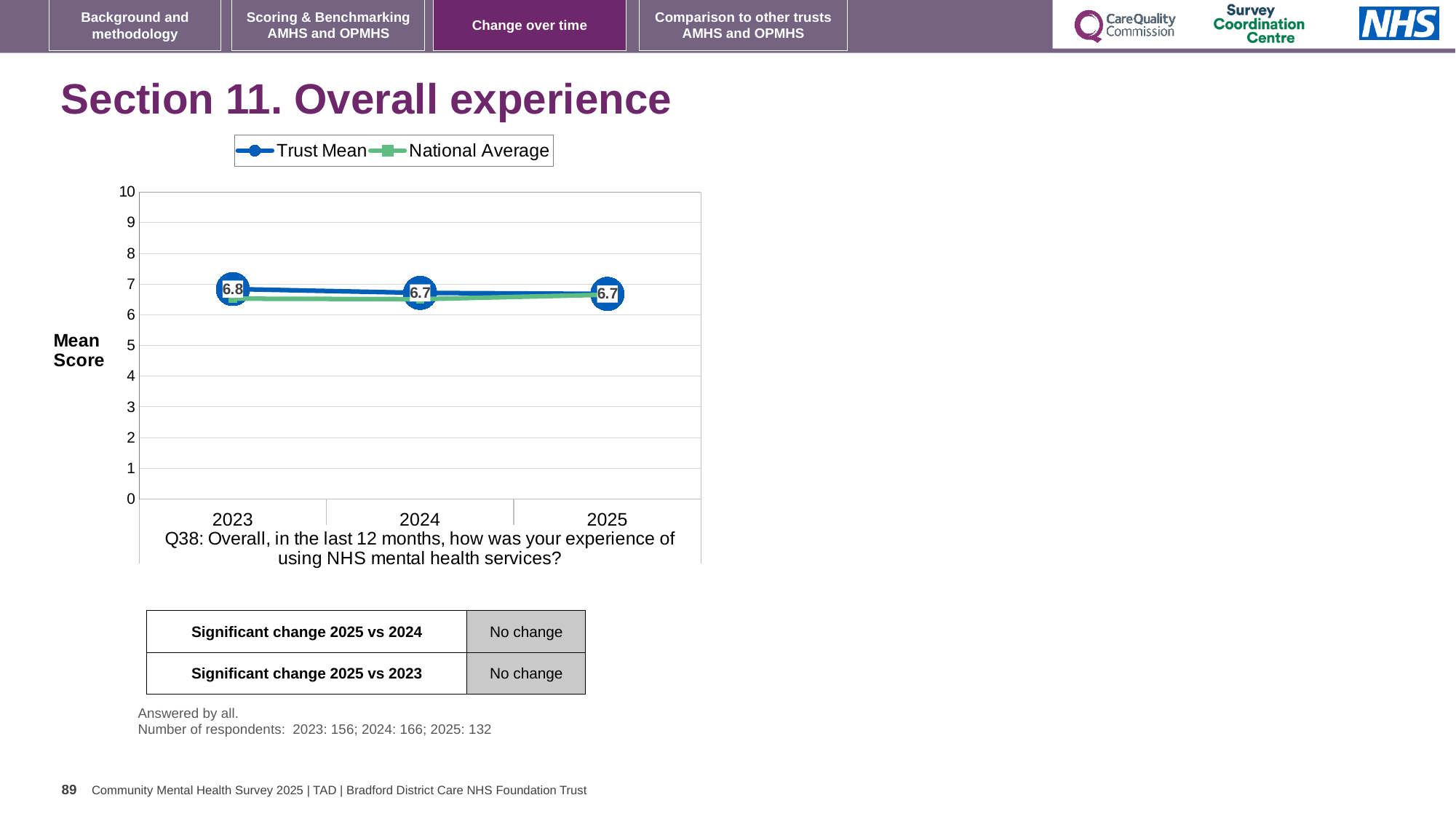
What is the difference between the Trust Mean in 2023 and in 2024? 0.1 Is the National Average value for 2023 greater or less than 7? less In which year is the Trust Mean highest? 2023 What kind of chart is shown on the slide? Line chart Which is larger, the Trust Mean for 2023 or for 2025? 2023 How many series does the legend list? 2 What is the Trust Mean value for 2025? 6.7 Does the Trust Mean rise or fall from 2023 to 2025? Fall What is the Trust Mean value for 2023? 6.8 What is the Trust Mean value for 2024? 6.7 How many years are plotted on the x axis? 3 What label is shown on the y axis of the chart? Mean Score